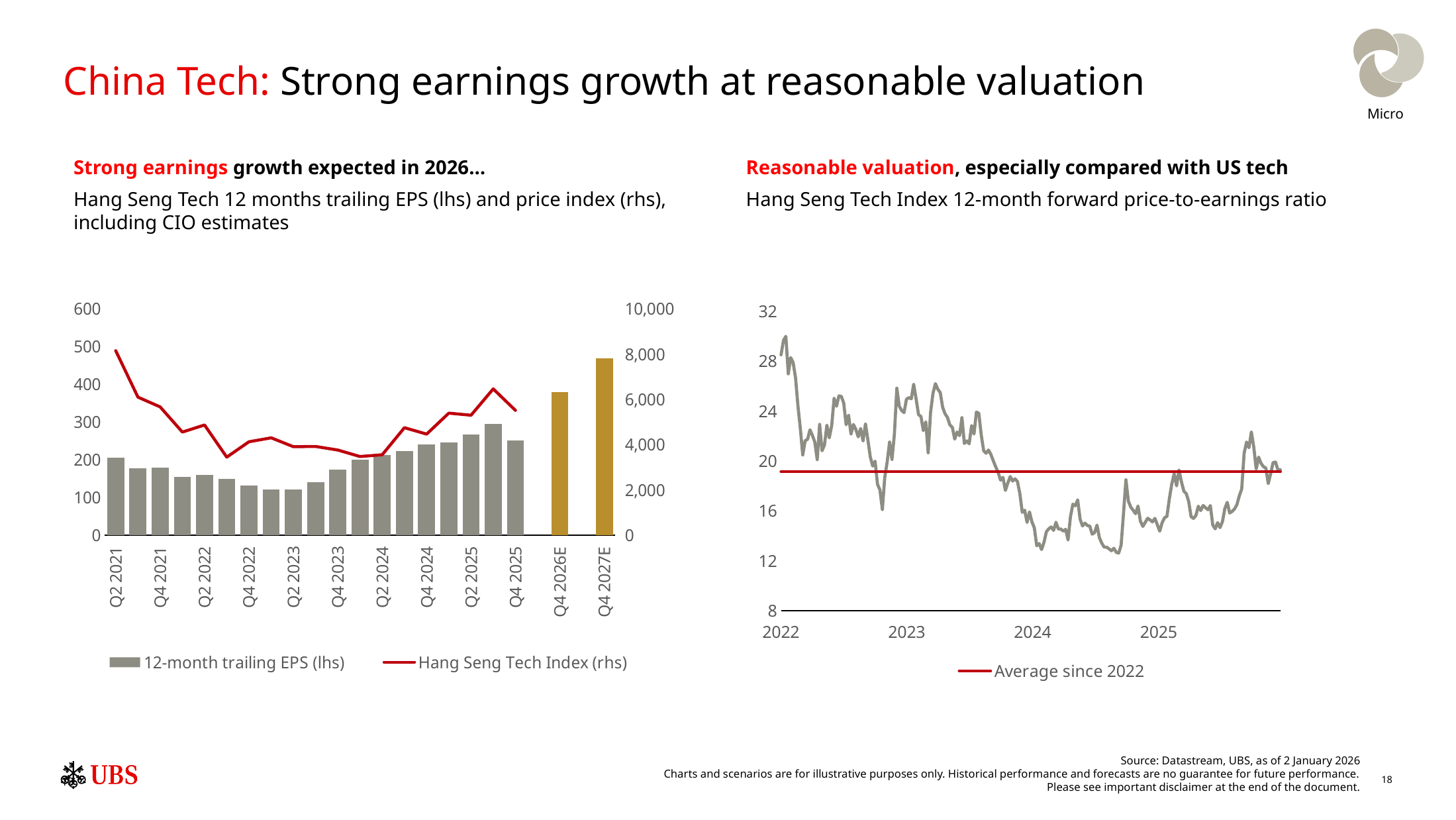
In the right chart, what is the single legend entry? Average since 2022 In the left chart, which bar is taller: Q4 2026E or Q4 2027E? Q4 2027E In the left chart, how many bars are shown in gold (the estimate bars)? 2 In the left chart, which category has the tallest bar? Q4 2027E In the left chart, is the 12-month trailing EPS bar for Q4 2026E greater or less than 300? greater What kind of chart is the right chart (Hang Seng Tech Index 12-month forward price-to-earnings ratio)? line chart In the left chart, is the 12-month trailing EPS bar for Q4 2027E greater or less than 400? greater In the left chart, does the Hang Seng Tech Index line rise or fall from Q2 2021 to Q4 2022? fall In the left chart, is the Hang Seng Tech Index (rhs) value at Q2 2021 greater or less than 6,000? greater In the left chart (Hang Seng Tech 12 months trailing EPS and price index), how many series does the legend list? 2